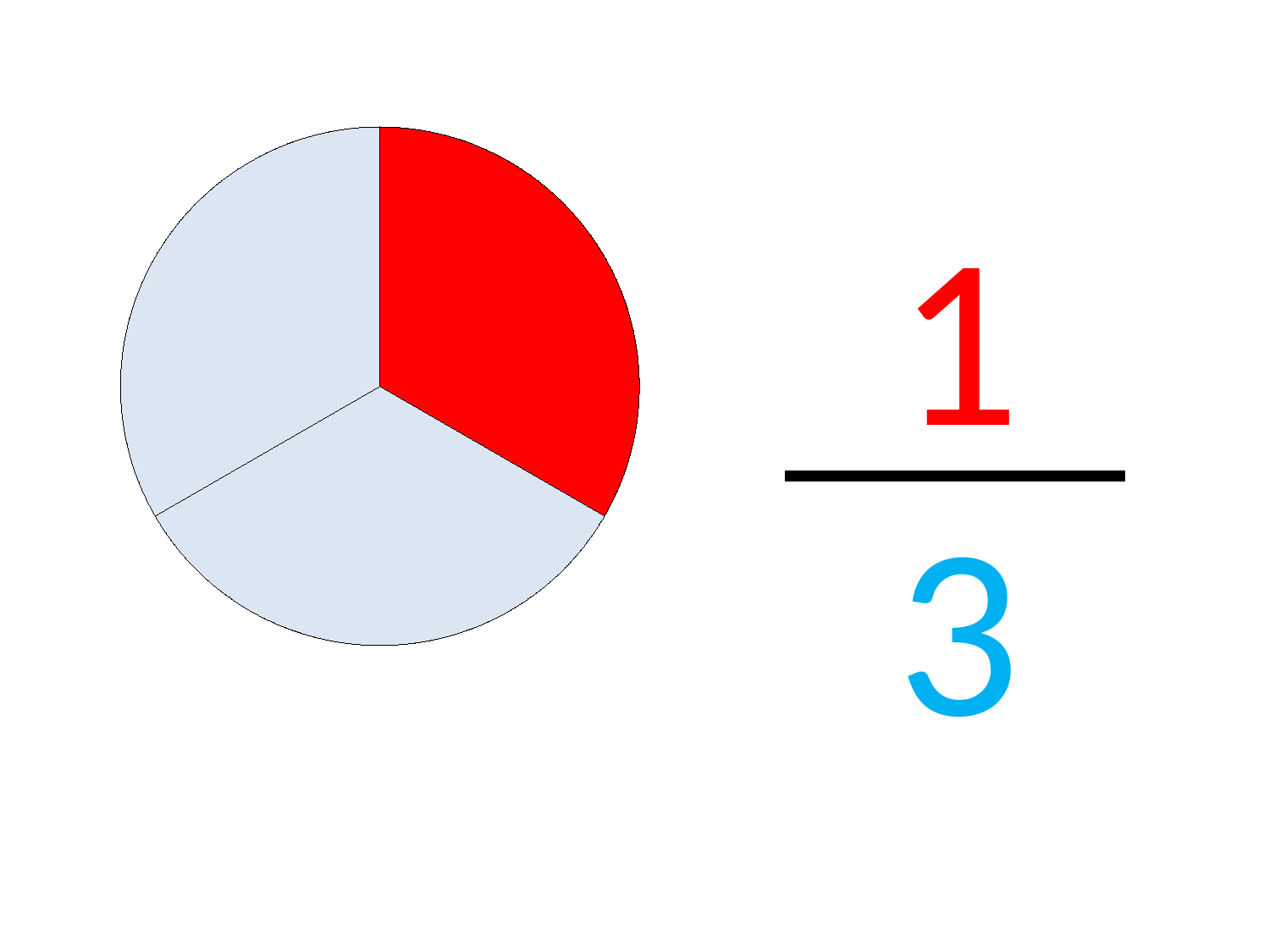
What fraction is written to the right of the pie chart? 1/3 How many slices of the pie chart are coloured red? 1 What kind of chart is shown on the slide? pie chart What share of the pie chart does the red slice represent, as shown by the fraction on the slide? 1/3 How many slices does the pie chart have? 3